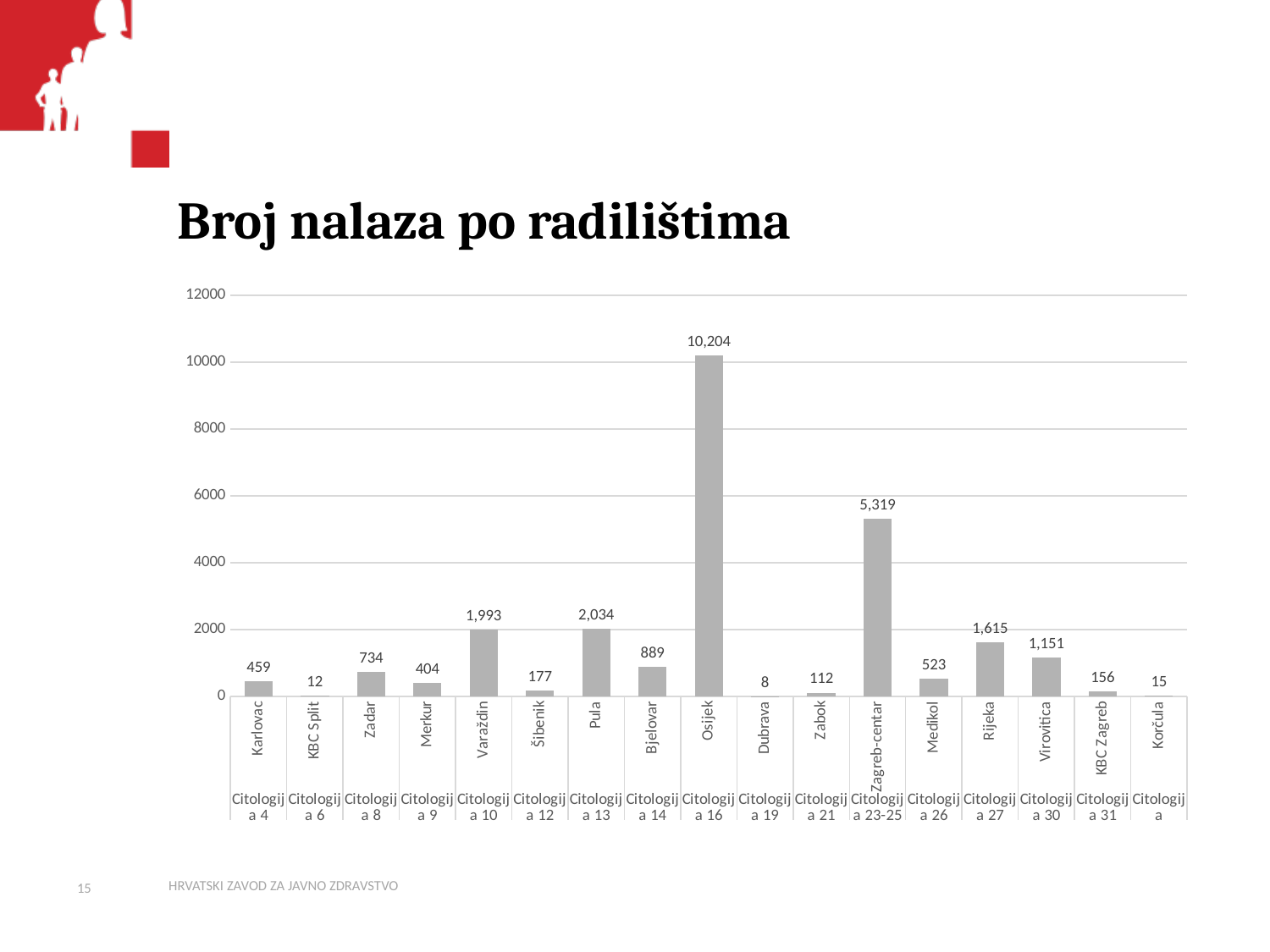
What is the value for Varaždin? 1,993 What is the difference between the values for Osijek and Zagreb-centar? 4,885 What is the value for Zagreb-centar? 5,319 Is the value for Zagreb-centar greater or less than 4000? greater What is the title of the chart? Broj nalaza po radilištima What is the value for Osijek? 10,204 What is the difference between the values for Pula and Varaždin? 41 How many categories are shown on the x axis? 17 What is the value for Dubrava? 8 Which category has the highest value? Osijek Which is larger, the value for Rijeka or the value for Virovitica? Rijeka Which category has the lowest value? Dubrava